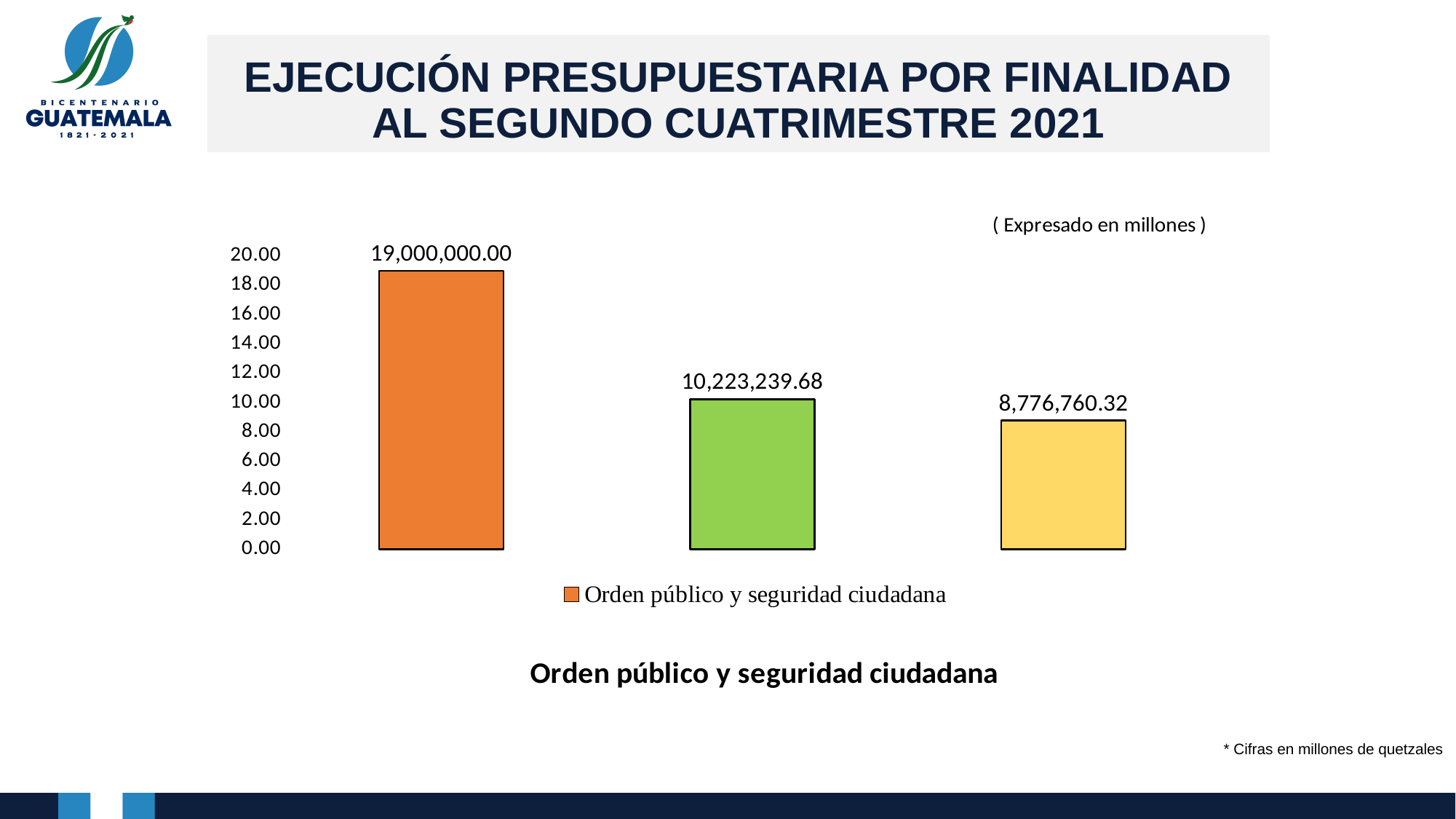
How many series does the legend list? 1 What is the difference between the green bar's value and the yellow bar's value? 1,446,479.36 How many bars are plotted in the chart? 3 What value is labelled on the orange bar? 19,000,000.00 Which bar has the lowest value? The yellow (rightmost) bar, 8,776,760.32 What value is labelled on the green (middle) bar? 10,223,239.68 Which is larger, the value of the green bar or the value of the yellow bar? The green bar What value is labelled on the yellow (rightmost) bar? 8,776,760.32 Which bar has the highest value? The orange (leftmost) bar, 19,000,000.00 What is the difference between the orange bar's value and the green bar's value? 8,776,760.32 Do the bar values rise or fall from left to right? Fall What kind of chart is shown on the slide? Bar chart